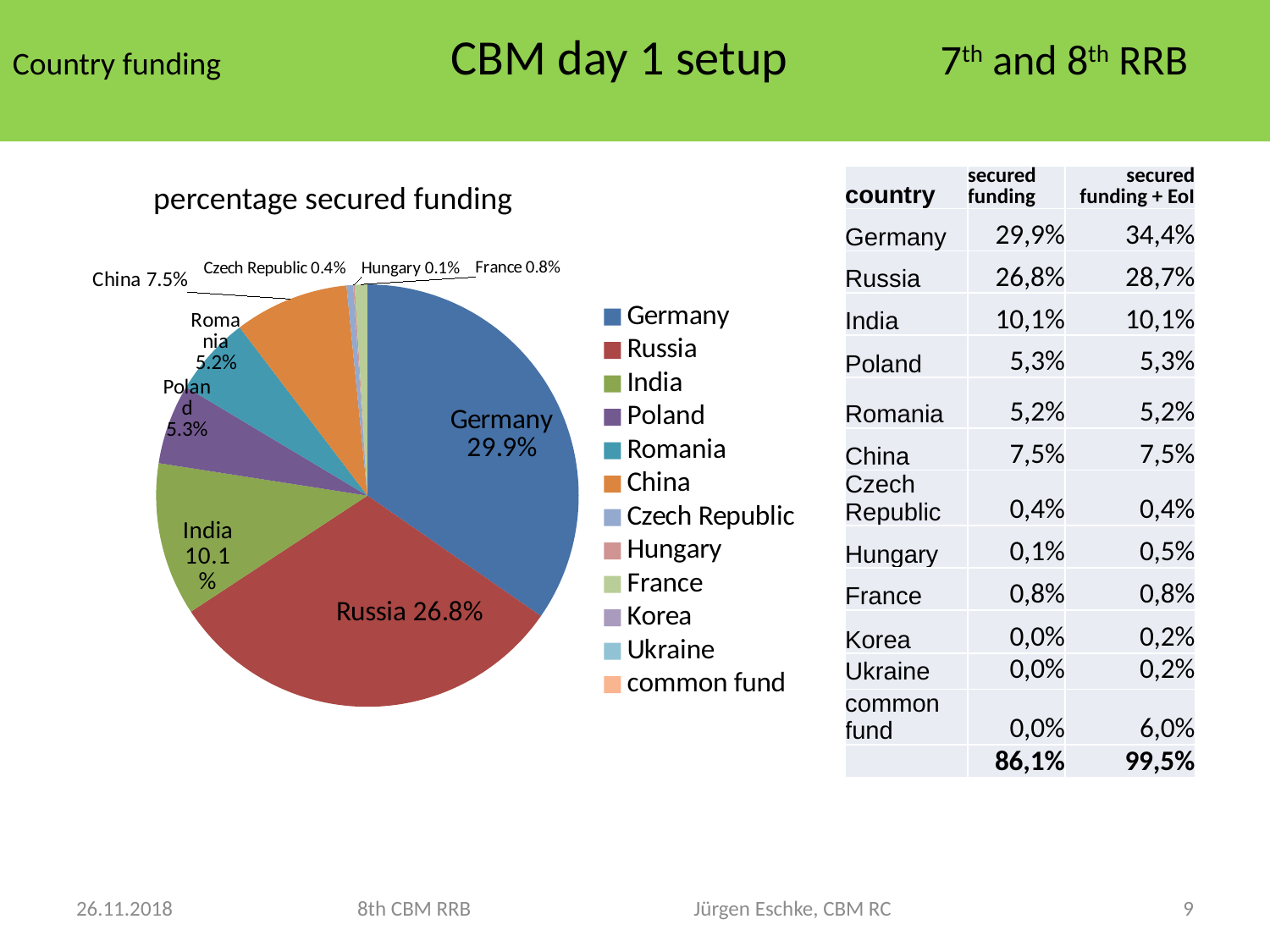
How many entries does the legend of the pie chart list? 12 What is the title of the pie chart? percentage secured funding What is the percentage shown for India in the pie chart? 10.1% What is the percentage shown for Russia in the pie chart? 26.8% What is the percentage shown for Hungary in the pie chart? 0.1% Which country has the largest slice in the pie chart? Germany Which slice is larger in the pie chart, India or China? India What is the difference between Germany's and Russia's percentages in the pie chart? 3.1% What is the percentage shown for China in the pie chart? 7.5% Which of the labelled slices in the pie chart is the smallest? Hungary What type of chart is shown under the title "percentage secured funding"? pie chart What is the percentage shown for Germany in the pie chart? 29.9%